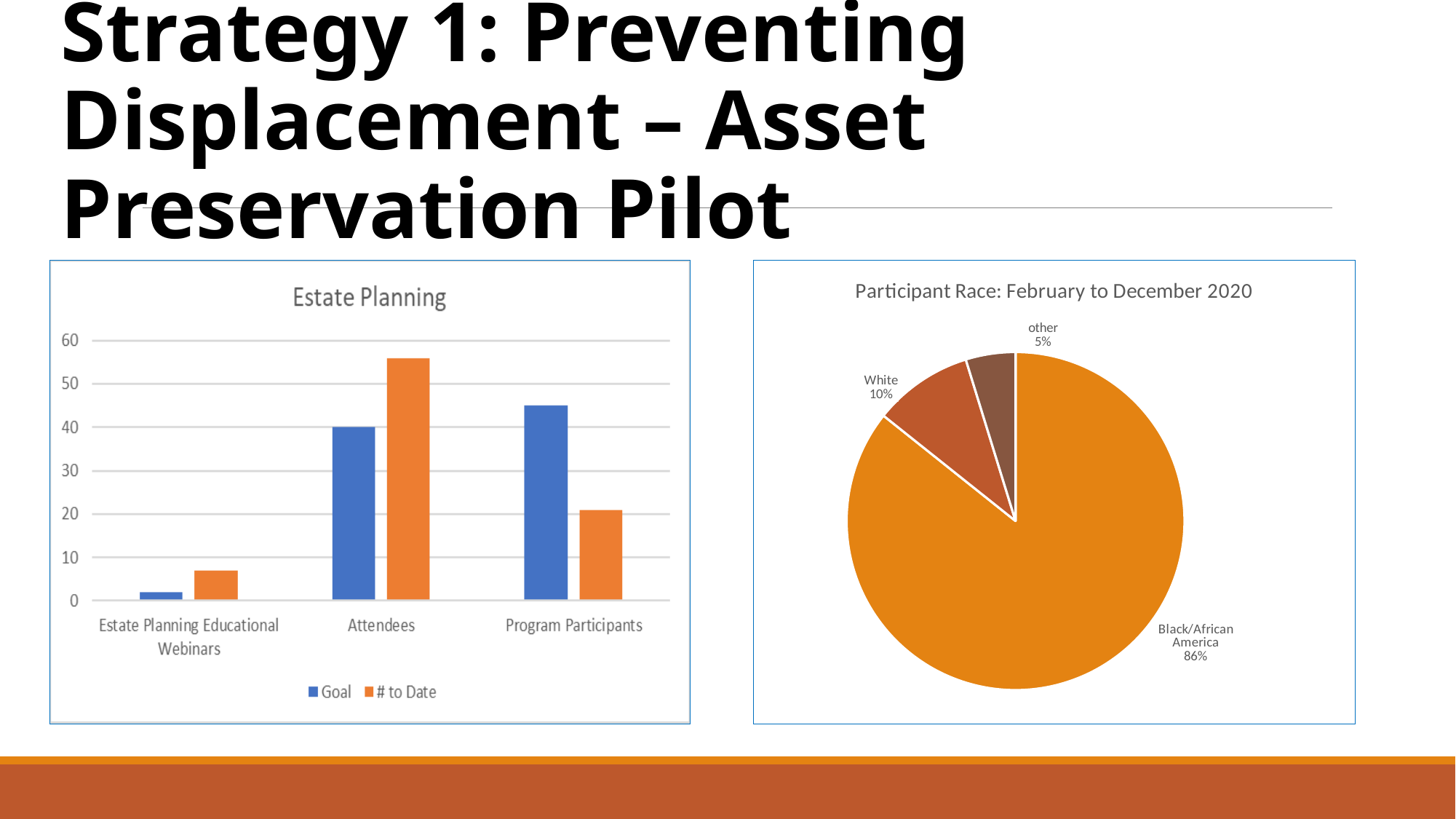
In the Participant Race: February to December 2020 chart, what percentage is White? 10% In the Estate Planning chart, is the # to Date value for Program Participants greater or less than 30? less In the Estate Planning chart, how many categories are shown on the x axis? 3 In the Estate Planning chart, which category has the highest # to Date value? Attendees In the Estate Planning chart, what is the Goal value for Attendees? 40 What kind of chart is the Participant Race: February to December 2020 chart? pie chart What kind of chart is the Estate Planning chart? bar chart In the Participant Race: February to December 2020 chart, which slice is the smallest? other In the Estate Planning chart, which is larger for Program Participants, Goal or # to Date? Goal In the Estate Planning chart, how many series does the legend list? 2 In the Participant Race: February to December 2020 chart, what share of participants is Black/African America? 86% In the Estate Planning chart, is the # to Date value for Attendees greater or less than 50? greater